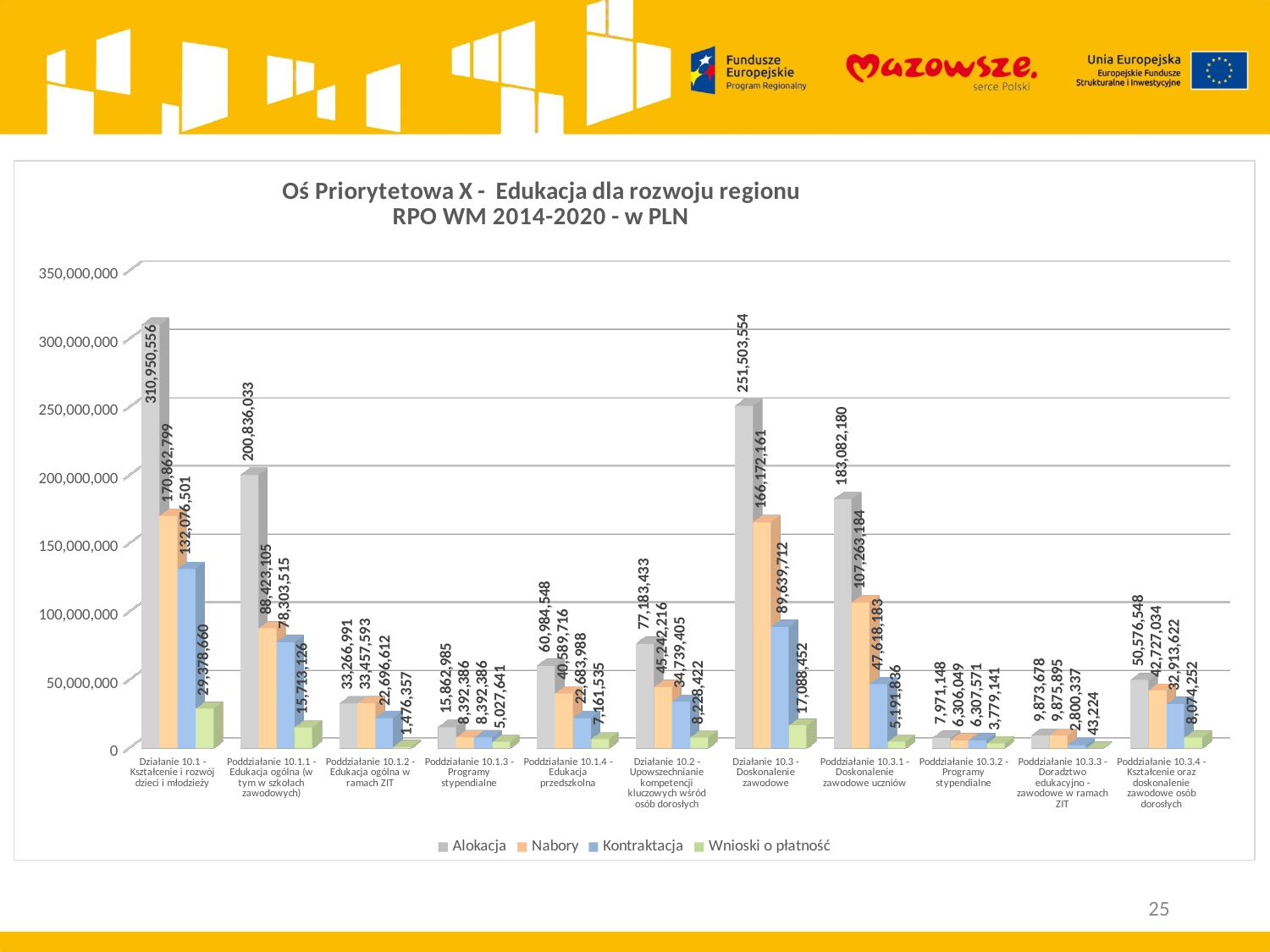
What kind of chart is shown on the slide? Bar chart Which category has the lowest Alokacja value? Poddziałanie 10.3.2 - Programy stypendialne What is the Nabory value for Poddziałanie 10.1.4 - Edukacja przedszkolna? 40,589,716 What is the Kontraktacja value for Działanie 10.3 - Doskonalenie zawodowe? 89,639,712 What is the difference between the Alokacja and Nabory values for Działanie 10.3 - Doskonalenie zawodowe? 85,331,393 Which is larger for Poddziałanie 10.3.1 - Doskonalenie zawodowe uczniów: Nabory or Kontraktacja? Nabory How many series does the legend list? 4 What is the Wnioski o płatność value for Poddziałanie 10.3.3 - Doradztwo edukacyjno-zawodowe w ramach ZIT? 43,224 What is the Alokacja value for Działanie 10.1 - Kształcenie i rozwój dzieci i młodzieży? 310,950,556 Is the Alokacja value for Poddziałanie 10.1.1 - Edukacja ogólna (w tym w szkołach zawodowych) greater or less than 150,000,000? greater Which category has the highest Alokacja value? Działanie 10.1 - Kształcenie i rozwój dzieci i młodzieży How many categories are shown on the x axis? 11